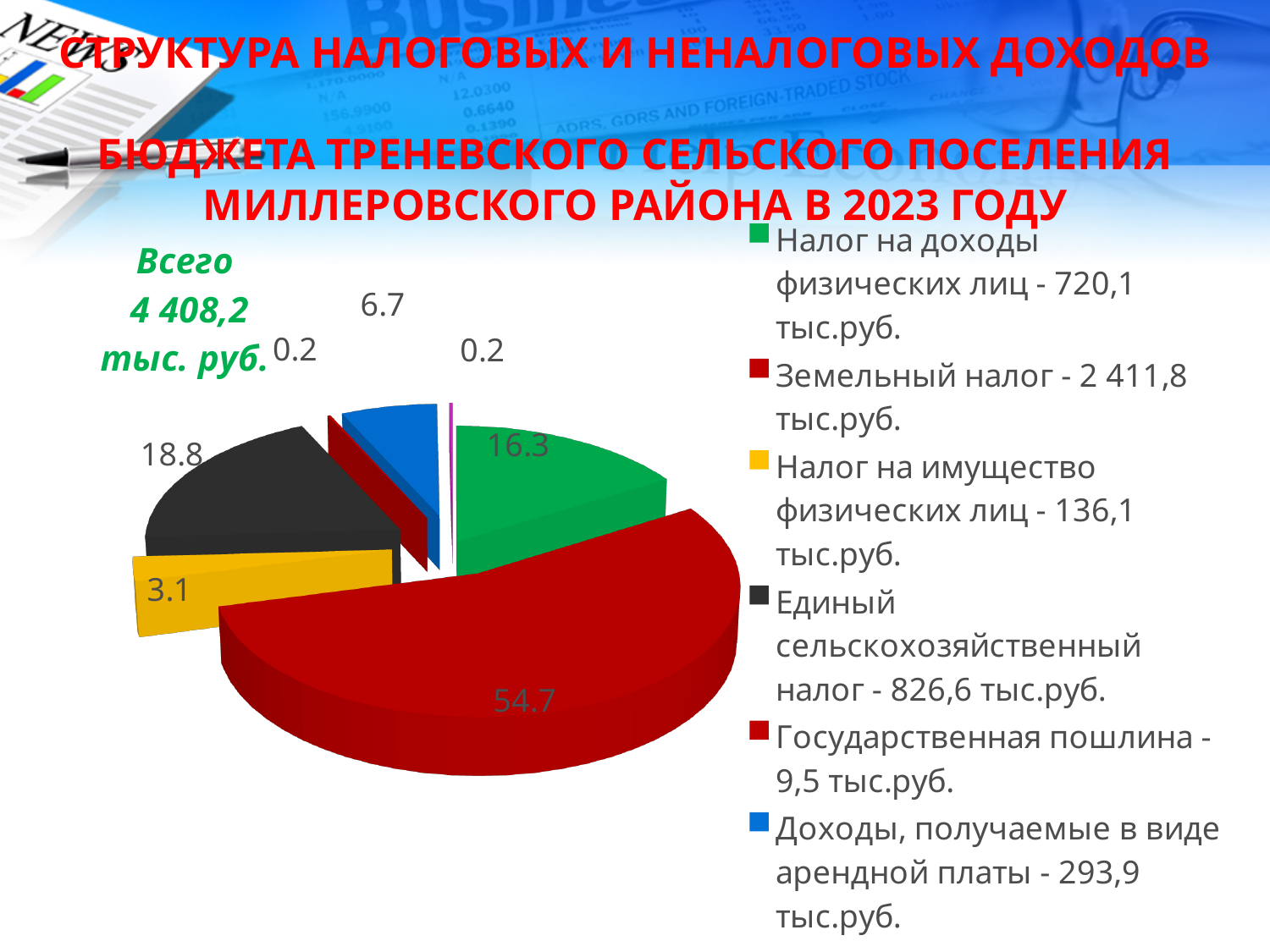
What kind of chart is shown on the slide? pie chart What total amount is stated next to the pie chart? 4 408,2 тыс. руб. Which category has the largest slice of the pie? Земельный налог What percentage share does the slice for Налог на доходы физических лиц have? 16.3 According to the legend, what is the amount for Государственная пошлина? 9,5 тыс.руб. According to the legend, what is the amount for Земельный налог? 2 411,8 тыс.руб. What percentage share does the slice for Доходы, получаемые в виде арендной платы have? 6.7 What percentage share does the slice for Налог на имущество физических лиц have? 3.1 Which slice is larger: Единый сельскохозяйственный налог or Доходы, получаемые в виде арендной платы? Единый сельскохозяйственный налог What percentage share does the slice for Земельный налог have? 54.7 What is the difference in percentage points between the Земельный налог slice and the Налог на доходы физических лиц slice? 38.4 What percentage share does the slice for Единый сельскохозяйственный налог have? 18.8